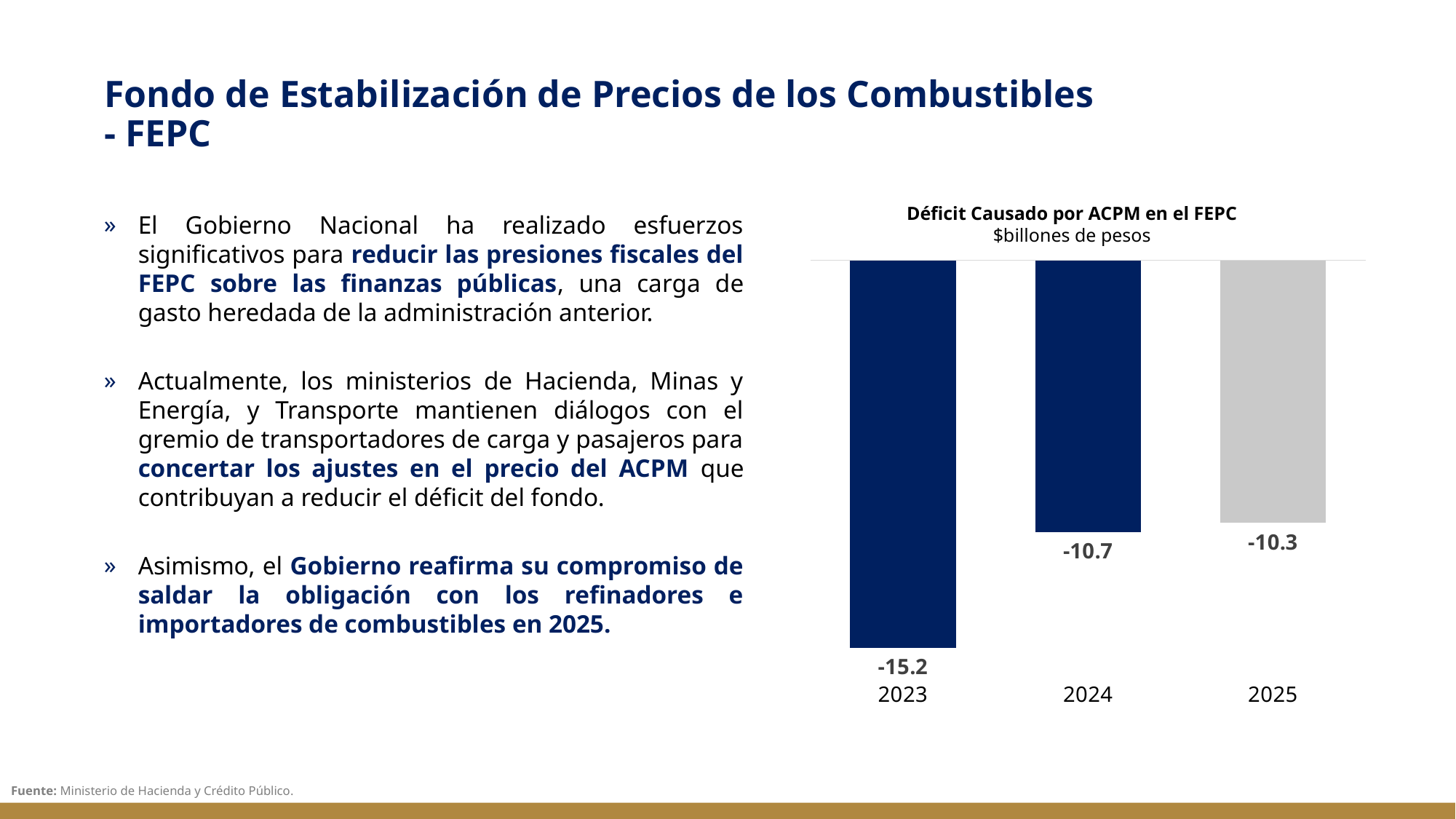
Which year has the smallest deficit (least negative value)? 2025 Is the deficit larger in 2023 or in 2025? 2023 What kind of chart is shown on the slide? Bar chart What is the value for 2024 in the chart? -10.7 Which year has the largest deficit (most negative value)? 2023 How many years are shown in the chart? 3 What is the value for 2025 in the chart? -10.3 What is the value for 2023 in the chart? -15.2 What is the title of the chart? Déficit Causado por ACPM en el FEPC Does the deficit shrink or grow from 2023 to 2025? Shrink What is the difference between the values for 2024 and 2025? 0.4 What is the difference between the values for 2023 and 2024? 4.5